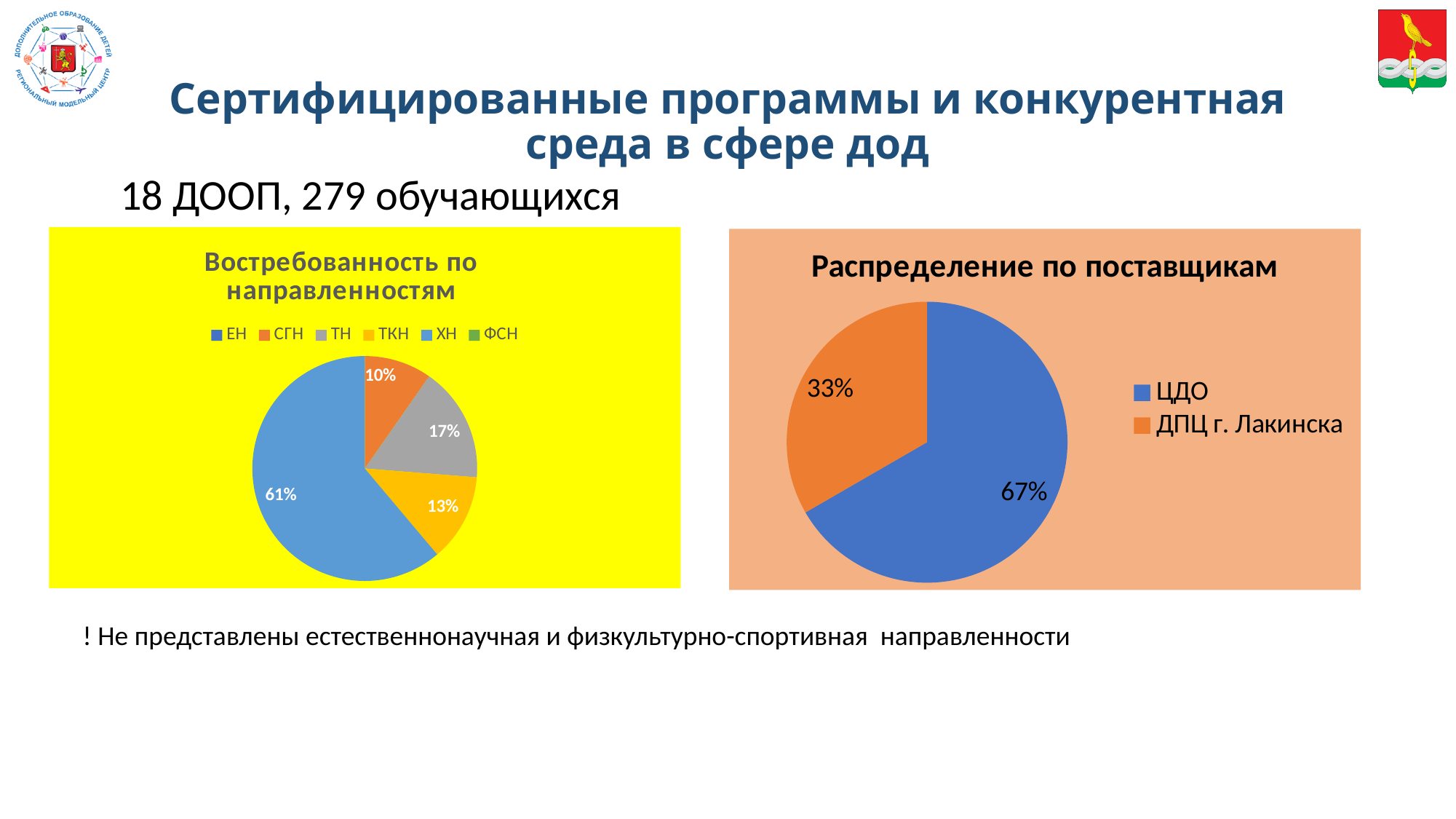
How many entries does the legend of the chart 'Распределение по поставщикам' list? 2 In the chart 'Востребованность по направленностям', what share does СГН have? 10% In the chart 'Распределение по поставщикам', which provider has the larger share? ЦДО In the chart 'Распределение по поставщикам', what is the difference between the shares of ЦДО and ДПЦ г. Лакинска? 34% In the chart 'Распределение по поставщикам', what share does ЦДО have? 67% What kind of chart is 'Распределение по поставщикам'? Pie chart How many entries does the legend of the chart 'Востребованность по направленностям' list? 6 In the chart 'Востребованность по направленностям', what share does ТН have? 17% In the chart 'Востребованность по направленностям', which category has the largest share? ХН In the chart 'Востребованность по направленностям', which is larger, the share of ТН or the share of ТКН? ТН